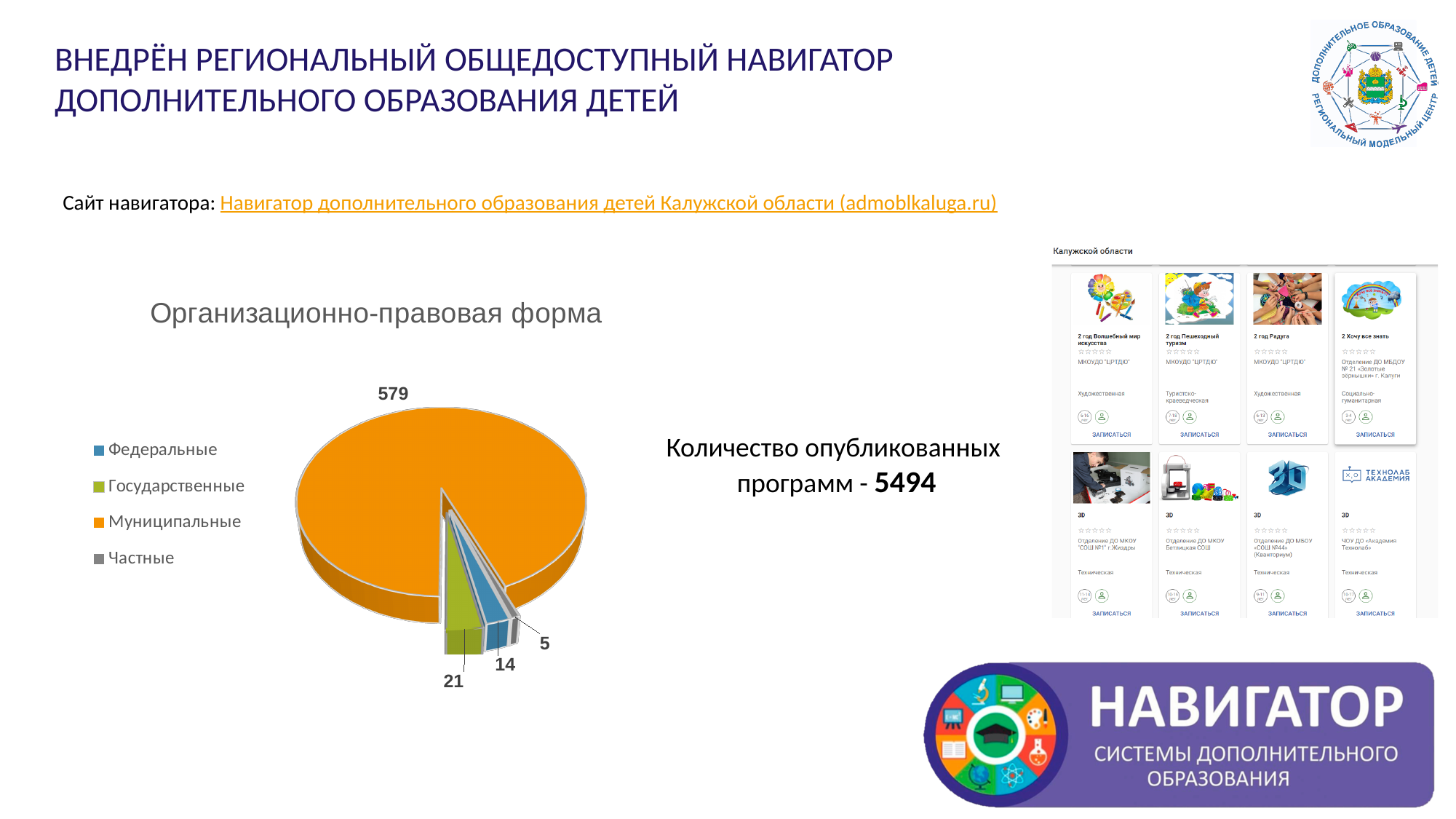
What is the difference between the values for Муниципальные and Государственные in the pie chart? 558 What is the total of all slices in the pie chart? 619 What is the value for Частные in the pie chart? 5 Which is larger in the pie chart, Государственные or Федеральные? Государственные What is the value for Федеральные in the pie chart? 14 What is the value for Государственные in the pie chart? 21 How many categories does the pie chart show? 4 What colour is the Муниципальные slice in the pie chart? Orange Which category has the smallest slice in the pie chart? Частные What is the value for Муниципальные in the pie chart? 579 Which category has the largest slice in the pie chart? Муниципальные What type of chart is shown under the title "Организационно-правовая форма"? Pie chart